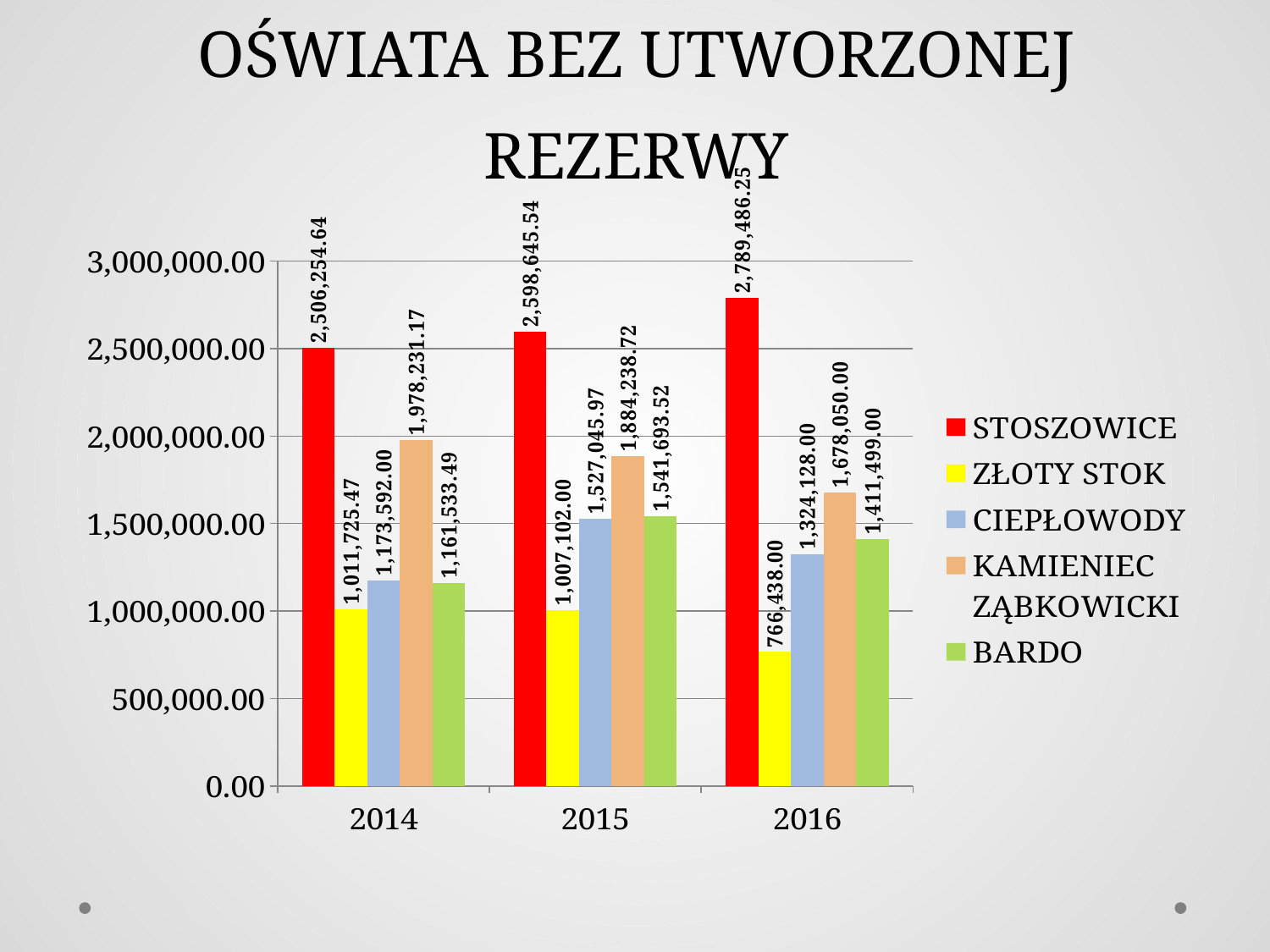
What kind of chart is shown on the slide? bar chart What is the difference between the STOSZOWICE values for 2016 and 2014? 283,231.61 What is the value for KAMIENIEC ZĄBKOWICKI in 2014? 1,978,231.17 Which is larger in 2015: CIEPŁOWODY or BARDO? BARDO How many series does the legend list? 5 Which series has the lowest value in 2016? ZŁOTY STOK What is the value for BARDO in 2015? 1,541,693.52 Is the value for CIEPŁOWODY in 2014 greater or less than 1,500,000.00? less What is the value for ZŁOTY STOK in 2016? 766,438.00 What is the value for STOSZOWICE in 2016? 2,789,486.25 Which series has the highest value in 2015? STOSZOWICE Do the values for STOSZOWICE rise or fall from 2014 to 2016? rise